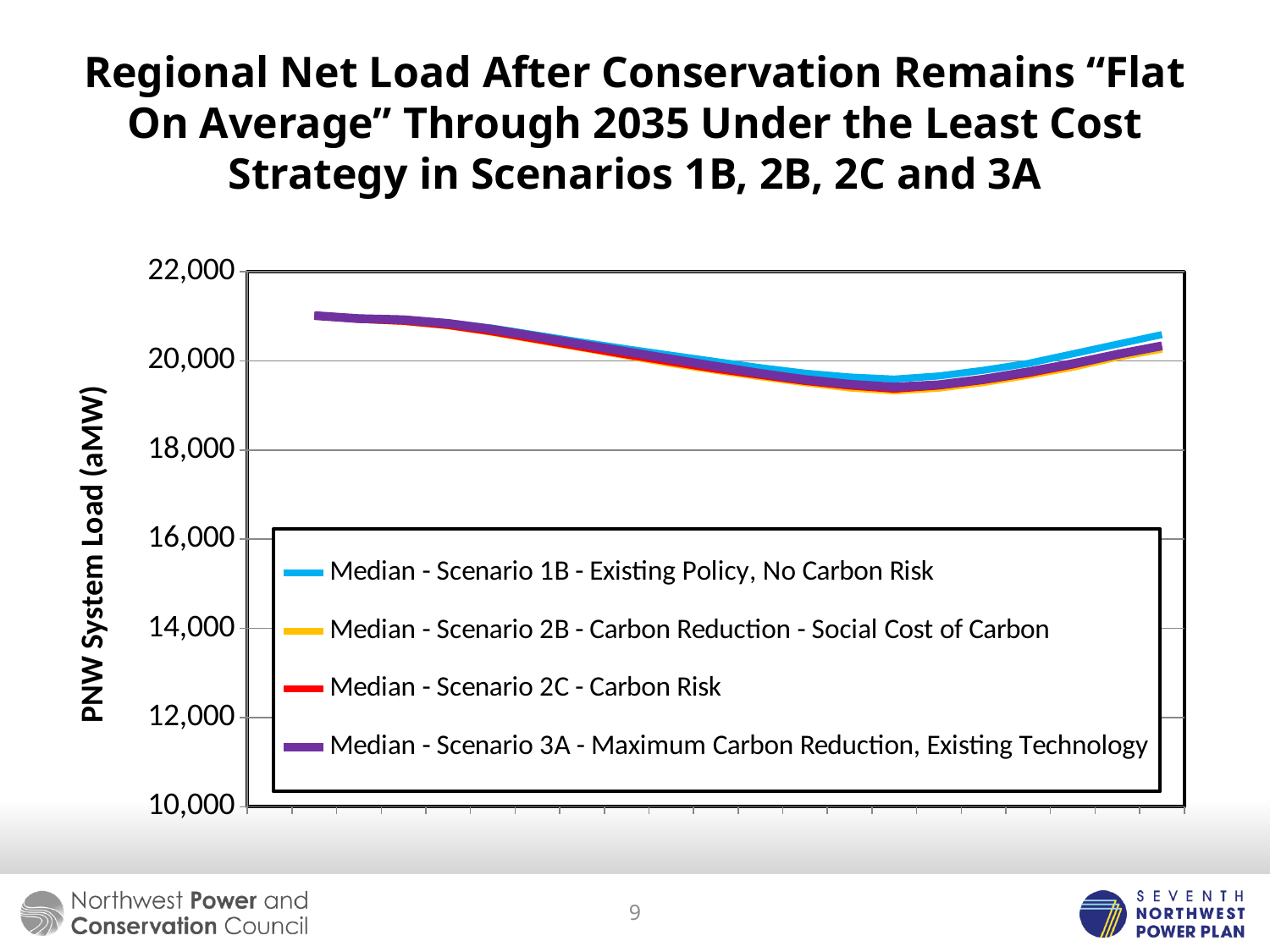
Which series has the highest value at the right-hand end of the chart? Median - Scenario 1B - Existing Policy, No Carbon Risk Is the lowest point of the Median - Scenario 2C line greater or less than 20,000? less Is the starting value of the Median - Scenario 1B line greater or less than 20,000? greater Do the lines rise or fall over the last third of the x axis? rise What is the label on the vertical axis of the chart? PNW System Load (aMW) What kind of chart is shown on the slide? line chart Do the lines rise or fall over the first half of the x axis? fall Is the lowest point of the Median - Scenario 2B line greater or less than 18,000? greater Which colour is used for the Median - Scenario 1B - Existing Policy, No Carbon Risk line? blue How many series does the legend list? 4 What is the lowest value shown on the vertical axis? 10,000